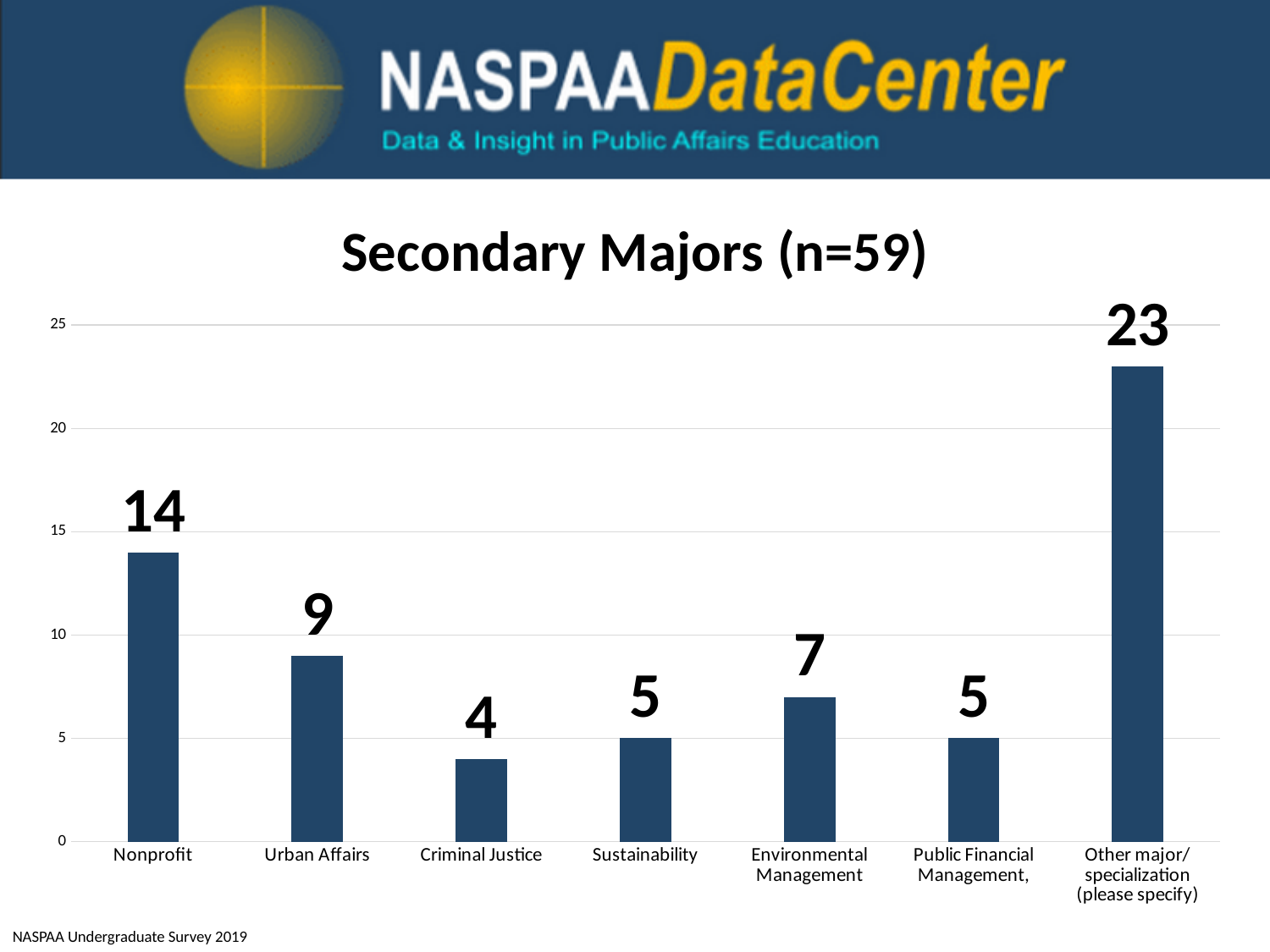
How many categories are shown on the x axis? 7 Which category has the lowest value? Criminal Justice What is the value for Nonprofit? 14 Which is larger, the value for Environmental Management or the value for Sustainability? Environmental Management What is the difference between the values for Nonprofit and Urban Affairs? 5 What is the value for Environmental Management? 7 What is the value for Other major/specialization (please specify)? 23 What kind of chart is this? Bar chart What is the value for Urban Affairs? 9 What is the difference between the values for Other major/specialization (please specify) and Nonprofit? 9 Which category has the highest value? Other major/specialization (please specify) What is the title of the chart? Secondary Majors (n=59)